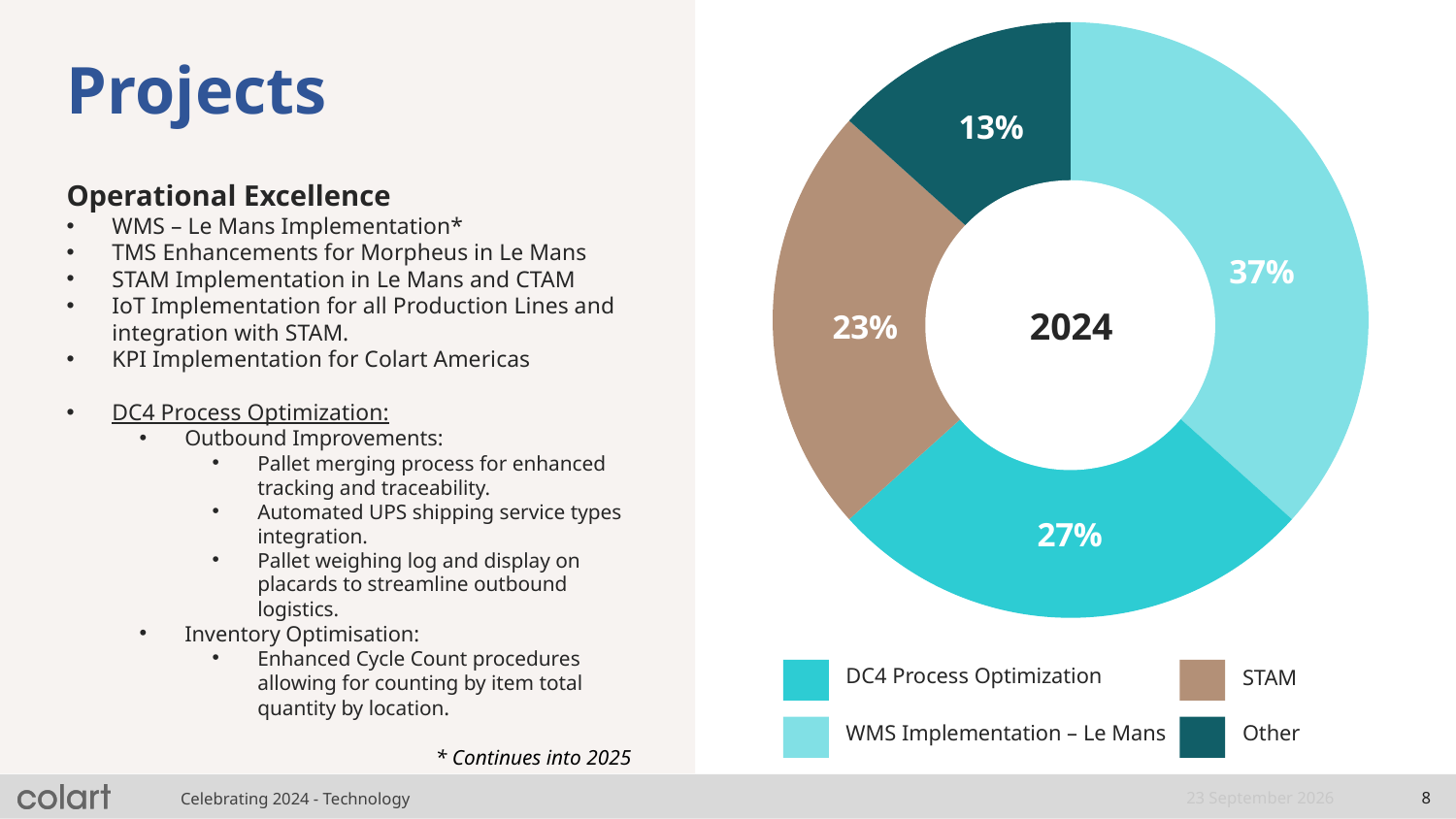
How many slices does the chart have? 4 What is the difference in percentage points between WMS Implementation – Le Mans and STAM? 14 What is the value shown for STAM in the chart? 23% Which is larger, the share for DC4 Process Optimization or the share for STAM? DC4 Process Optimization What percentage does DC4 Process Optimization account for in the chart? 27% What percentage is labelled for the Other slice? 13% Which category has the largest share of the chart? WMS Implementation – Le Mans What share of the 2024 donut chart is WMS Implementation – Le Mans? 37% How many entries does the chart legend list? 4 Which category has the smallest share of the chart? Other What year is shown in the centre of the donut chart? 2024 What type of chart is shown on the slide? Donut (pie) chart